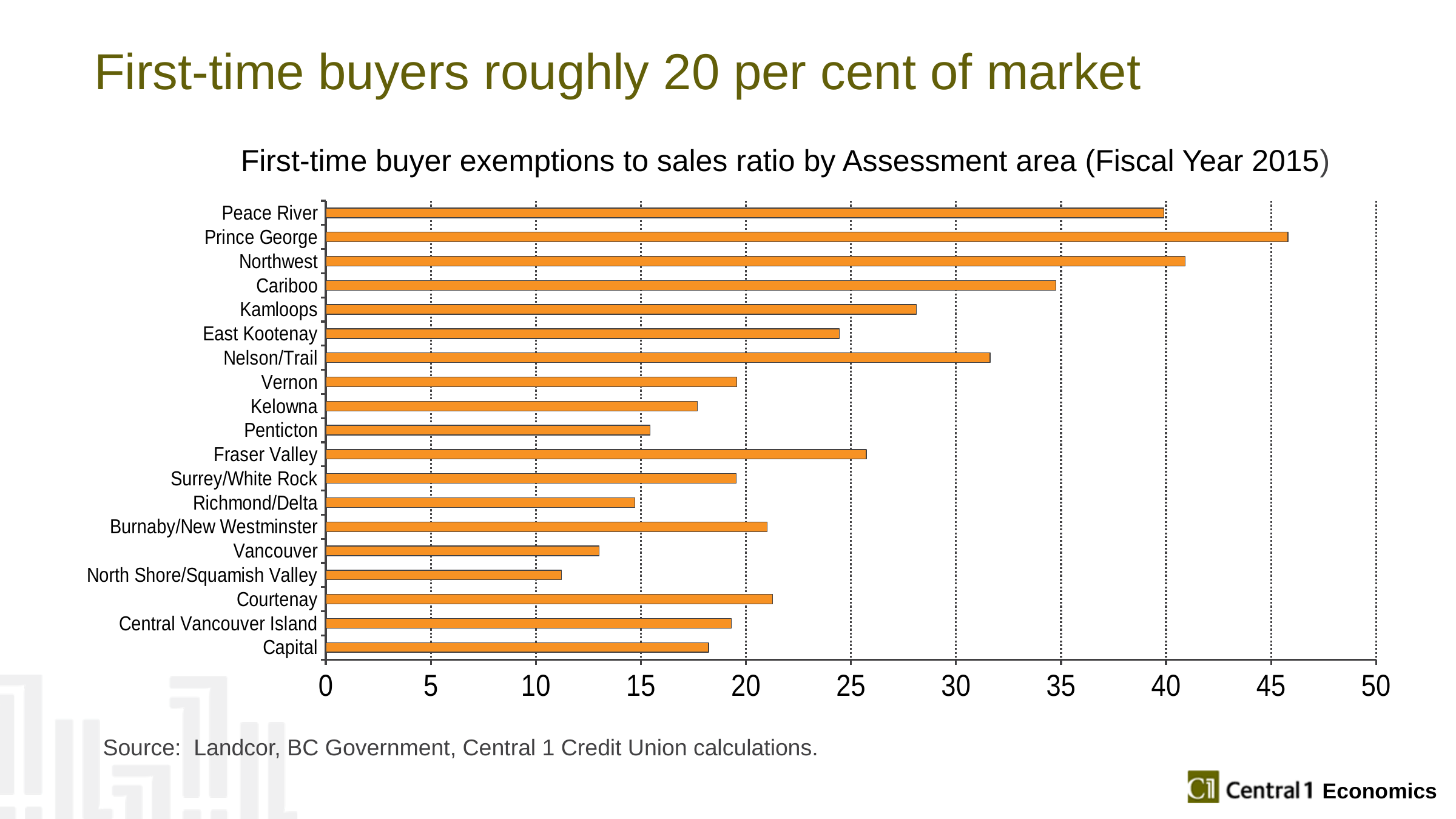
How many assessment areas are plotted on the chart? 19 What kind of chart is shown on the slide? bar chart Is the value for Kamloops greater or less than 25? greater What is the title of the chart? First-time buyer exemptions to sales ratio by Assessment area (Fiscal Year 2015) Is the value for Vancouver greater or less than 15? less Is the value for Kelowna greater or less than 20? less Which has the larger value, Cariboo or Kamloops? Cariboo Which assessment area has the highest first-time buyer exemptions to sales ratio? Prince George Which has the larger value, Vancouver or Burnaby/New Westminster? Burnaby/New Westminster Which assessment area has the lowest first-time buyer exemptions to sales ratio? North Shore/Squamish Valley